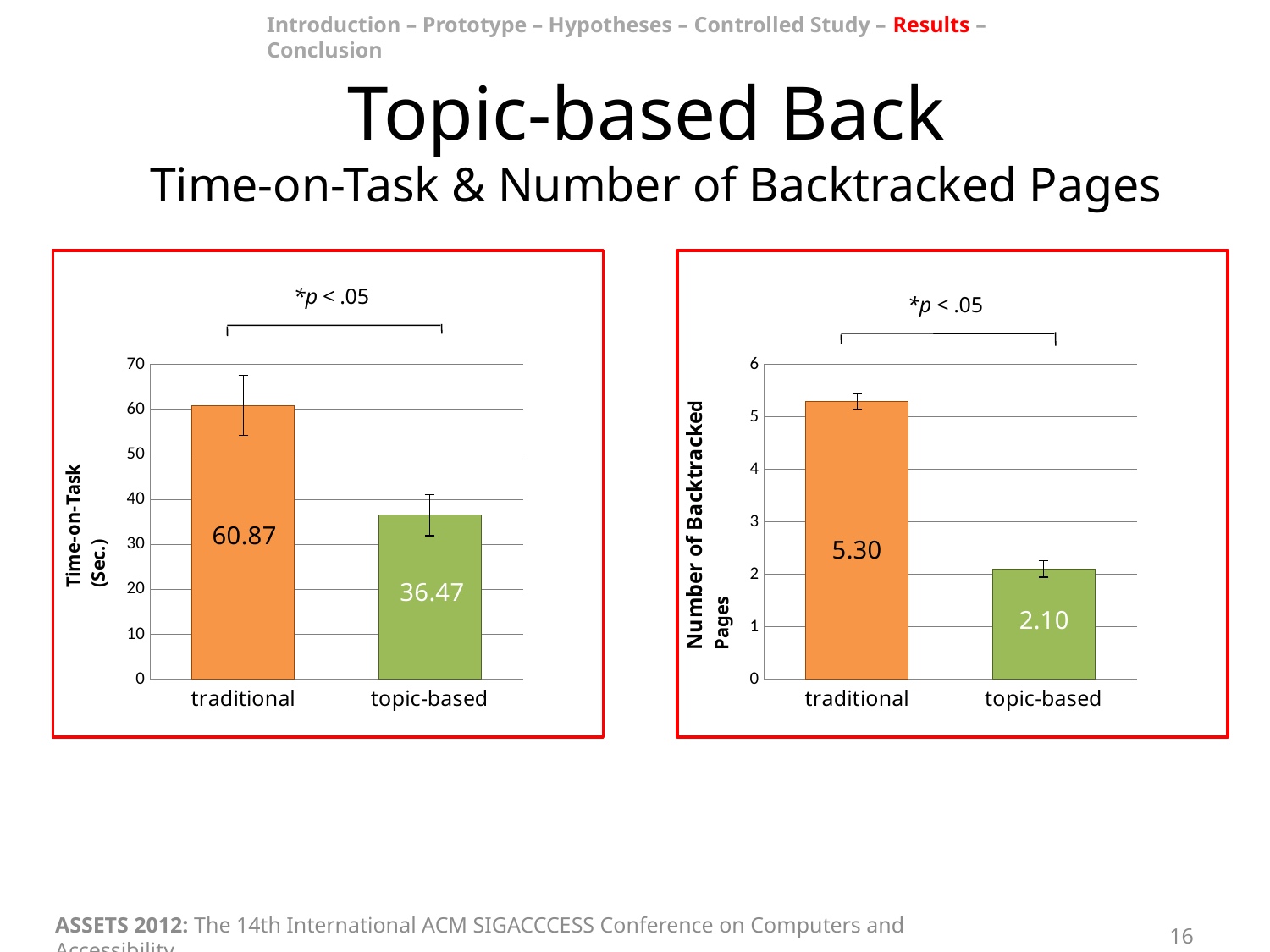
In the right chart (Number of Backtracked Pages), what is the difference between the traditional and topic-based values? 3.20 In the right chart (Number of Backtracked Pages), which category has the lowest value? topic-based In the left chart (Time-on-Task), what is the value for topic-based? 36.47 In the right chart (Number of Backtracked Pages), what is the value for topic-based? 2.10 What kind of chart is the right chart (Number of Backtracked Pages)? bar chart In the left chart (Time-on-Task), what is the value for traditional? 60.87 In the right chart (Number of Backtracked Pages), which is larger, traditional or topic-based? traditional In the left chart (Time-on-Task), which category has the highest value? traditional In the left chart (Time-on-Task), is the value for topic-based greater or less than 40? less In the right chart (Number of Backtracked Pages), what is the value for traditional? 5.30 In the left chart (Time-on-Task), what is the difference between the traditional and topic-based values? 24.40 How many categories are shown in the left chart (Time-on-Task)? 2